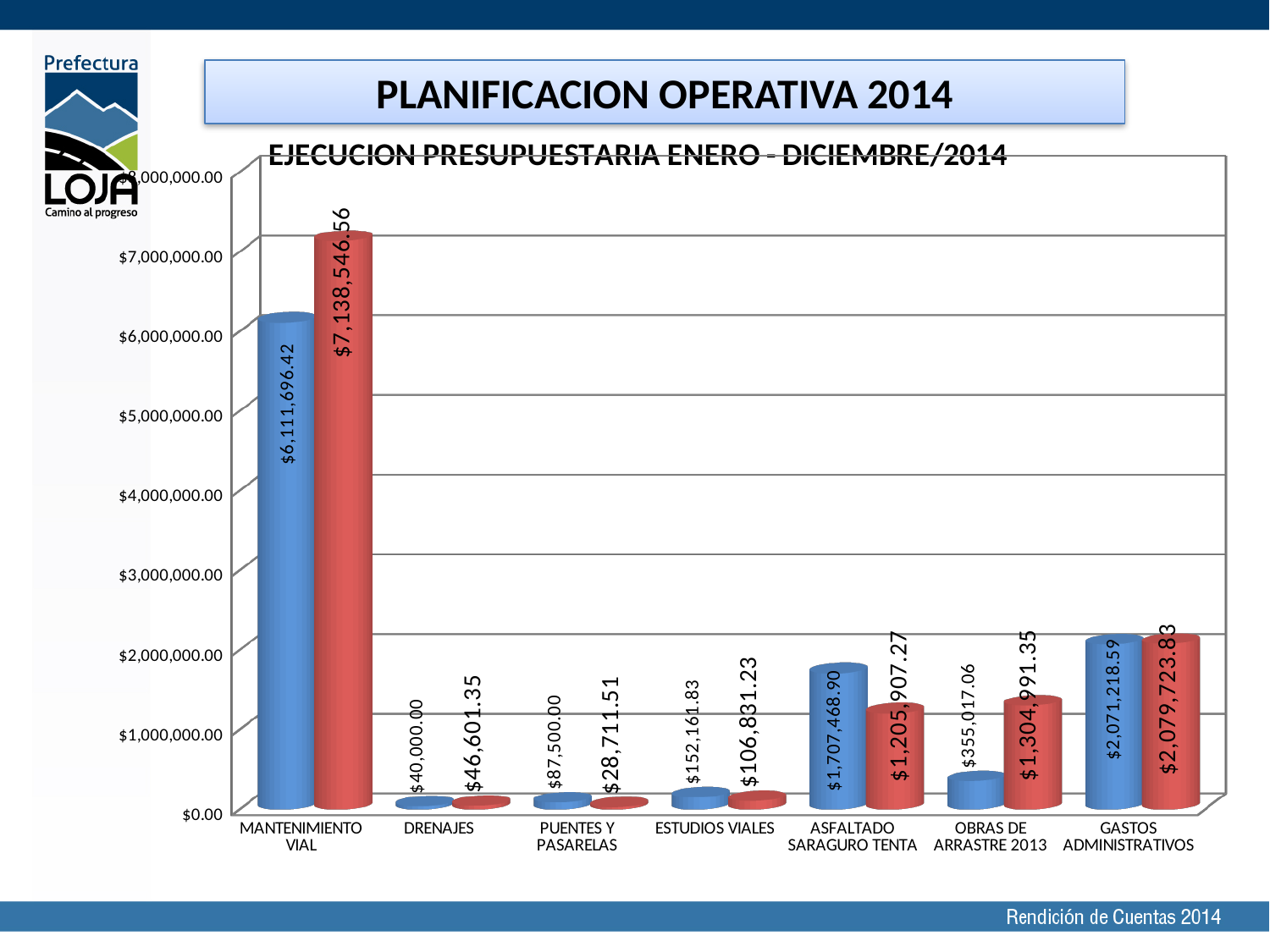
Which category has the lowest blue bar? DRENAJES What is the value of the red bar for OBRAS DE ARRASTRE 2013? $1,304,991.35 What is the value of the blue bar for ASFALTADO SARAGURO TENTA? $1,707,468.90 For ESTUDIOS VIALES, which bar is larger, the blue or the red? blue What is the difference between the red and blue bars for MANTENIMIENTO VIAL? $1,026,850.14 What is the title of the chart? EJECUCION PRESUPUESTARIA ENERO - DICIEMBRE/2014 What is the value of the blue bar for MANTENIMIENTO VIAL? $6,111,696.42 What is the difference between the red and blue bars for PUENTES Y PASARELAS? $58,788.49 What kind of chart is shown on the slide? bar chart How many categories are shown on the x axis? 7 Which category has the highest red bar? MANTENIMIENTO VIAL What is the value of the red bar for MANTENIMIENTO VIAL? $7,138,546.56